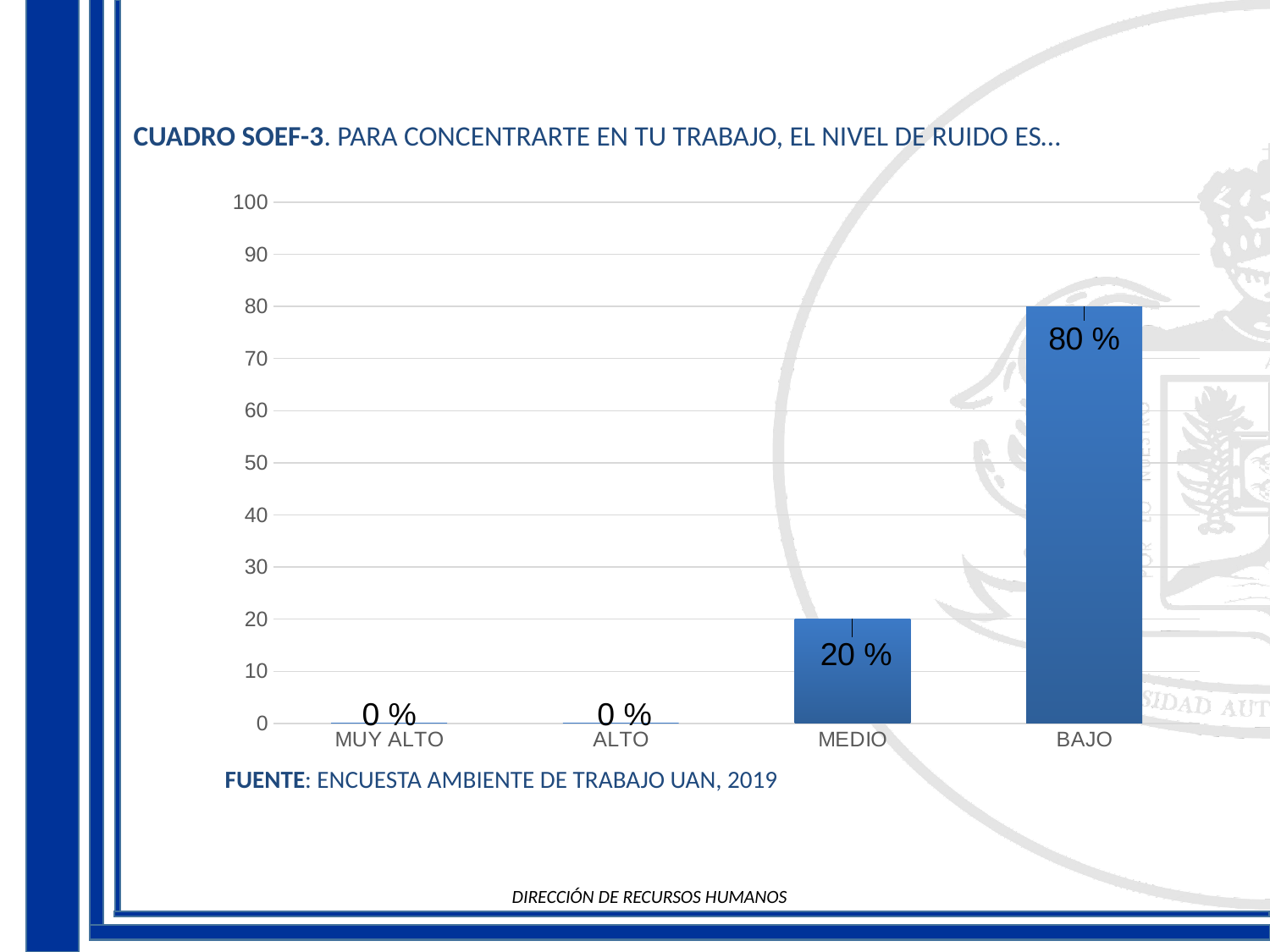
What is the value for MUY ALTO? 0 % What kind of chart is shown on the slide? bar chart Which category has the highest value? BAJO What is the difference between the values for BAJO and MEDIO? 60 % What is the value for BAJO? 80 % Is the value for BAJO greater or less than 50? greater What source is cited below the chart? ENCUESTA AMBIENTE DE TRABAJO UAN, 2019 How many categories are shown on the x axis? 4 Do the values rise or fall from MUY ALTO to BAJO along the x axis? rise What is the value for ALTO? 0 % What is the value for MEDIO? 20 % Which is larger, the value for MEDIO or the value for BAJO? BAJO